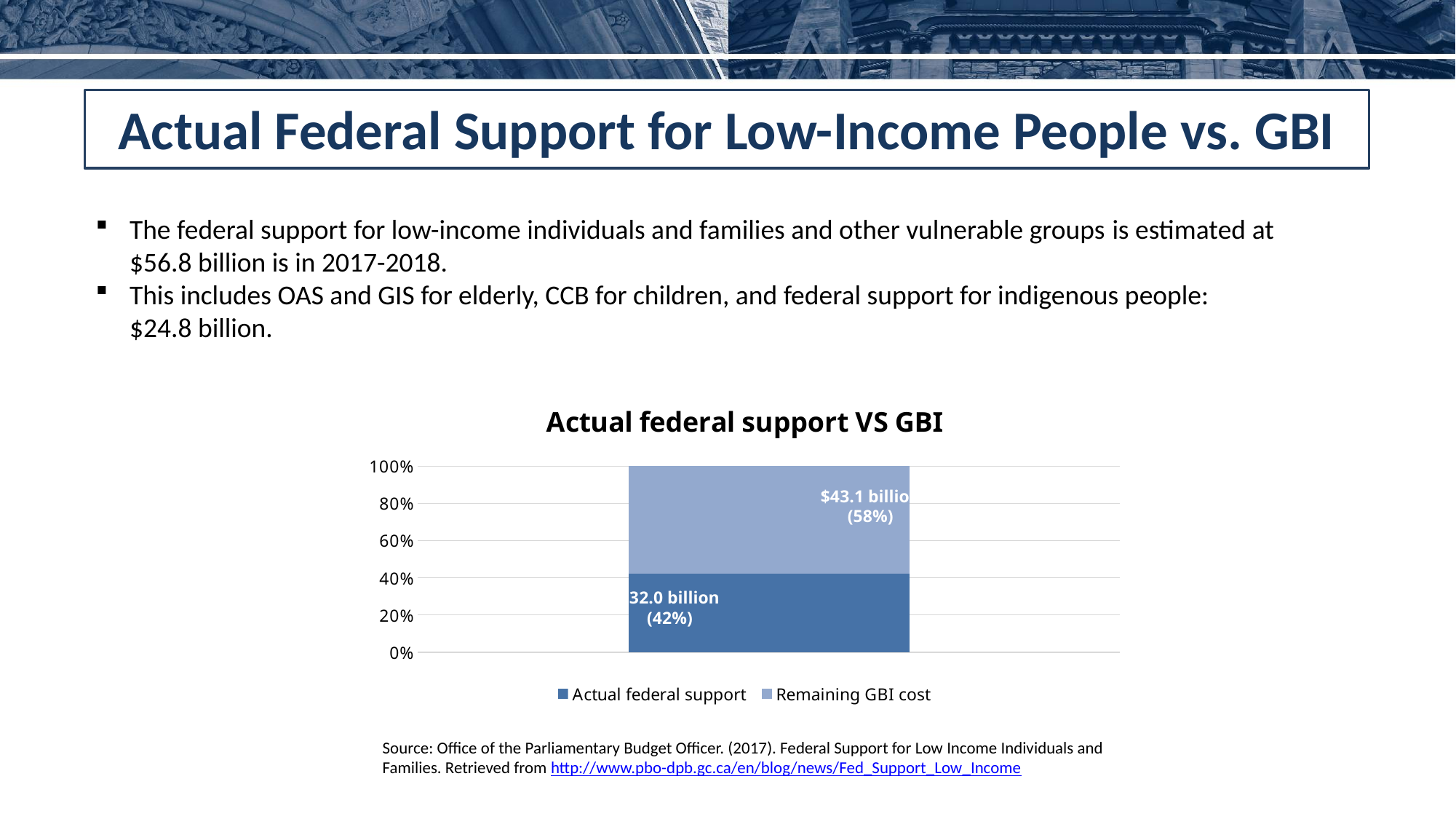
Is the share for Actual federal support greater or less than 50%? less Which series makes up the smallest share of the bar? Actual federal support Which segment is larger, Actual federal support or Remaining GBI cost? Remaining GBI cost What percentage of the bar is labelled for Actual federal support? 42% Which series makes up the largest share of the bar? Remaining GBI cost What dollar amount is labelled for the Remaining GBI cost segment? $43.1 billion What is the difference in percentage points between the Remaining GBI cost share and the Actual federal support share? 16 percentage points What is the title of the chart? Actual federal support VS GBI How many series does the chart legend list? 2 What percentage of the bar is labelled for Remaining GBI cost? 58% What are the two entries in the chart legend? Actual federal support; Remaining GBI cost What kind of chart is shown on the slide? Stacked bar chart